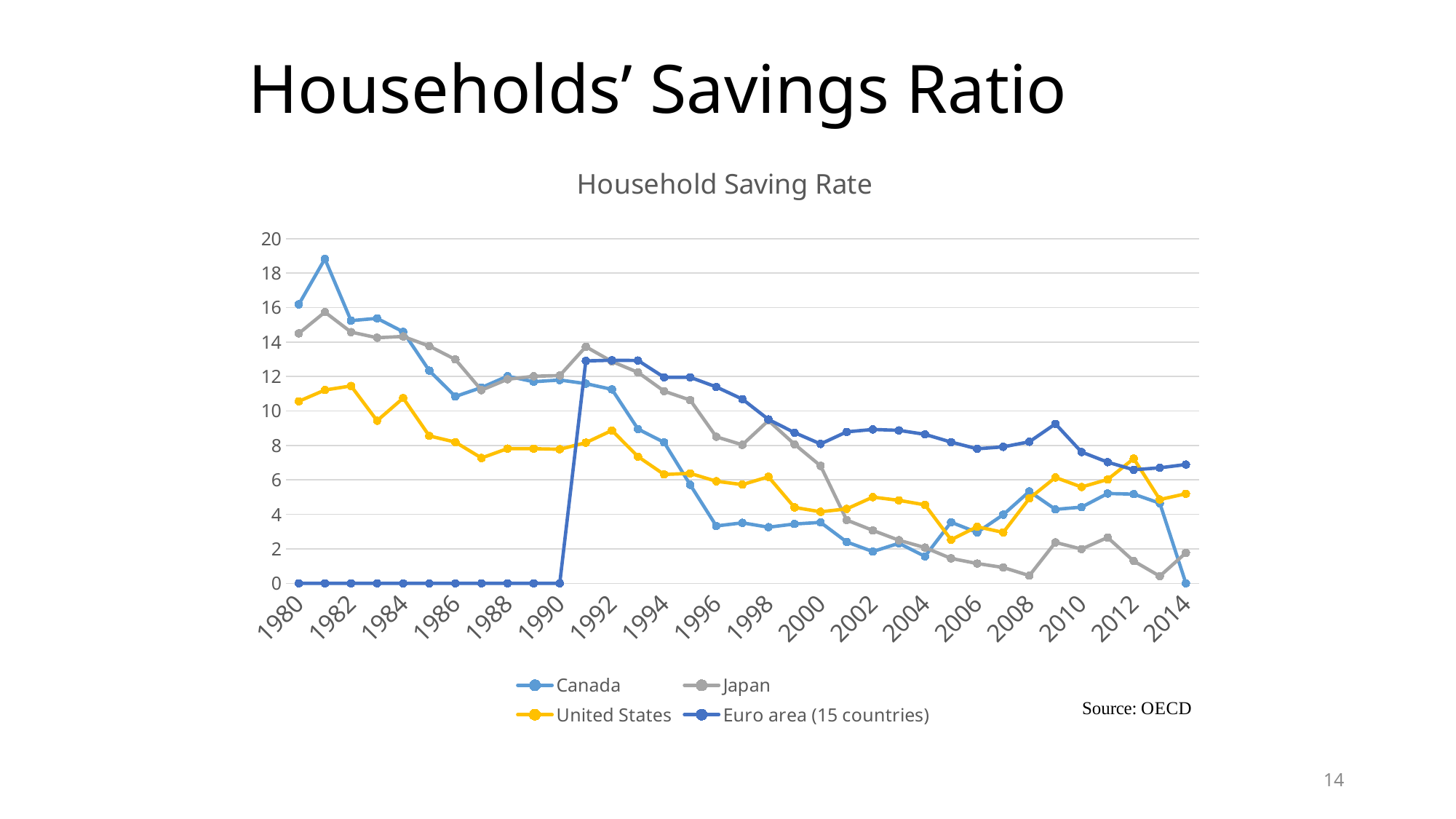
Which series has the highest value in 2014? Euro area (15 countries) What is the title of the chart? Household Saving Rate Does the value for Japan rise or fall overall from 1980 to 2014? fall What is the value for Canada in 2014? 0 In 2000, which is larger: the value for Euro area (15 countries) or the value for Canada? Euro area (15 countries) Which series has the lowest value in 2014? Canada Is the value for Canada in 1981 greater or less than 16? greater What is the value for Euro area (15 countries) in 1980? 0 Is the value for Japan in 2013 greater or less than 2? less What kind of chart is shown on the slide? line chart How many series does the legend list? 4 Which series has the highest value in 1981? Canada